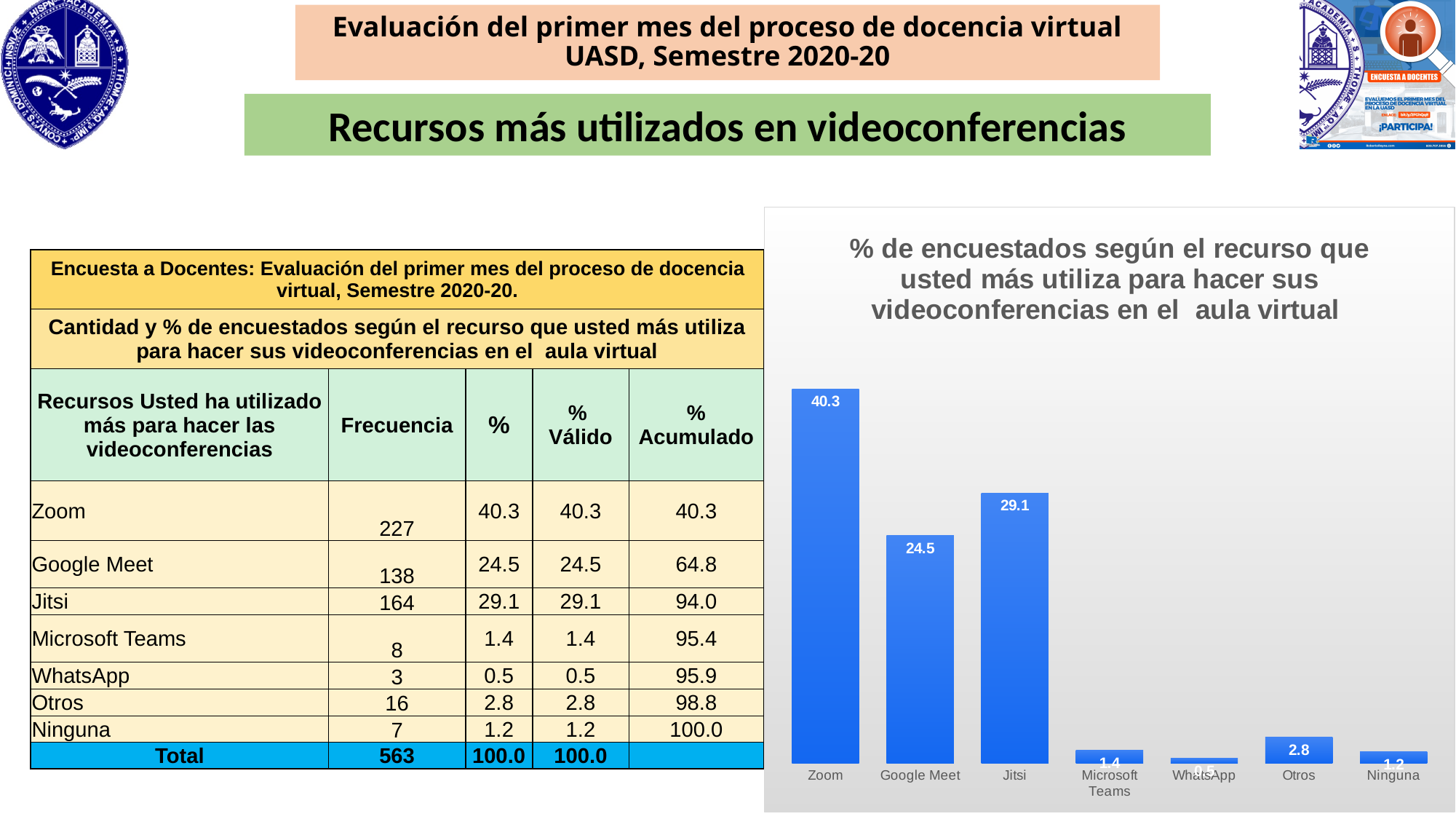
What is the value for Google Meet in the bar chart? 24.5 How many categories are shown in the bar chart? 7 What is the difference between the values for Zoom and Jitsi in the bar chart? 11.2 What is the difference between the values for Jitsi and Google Meet in the bar chart? 4.6 What is the value for Zoom in the bar chart? 40.3 What is the value for Jitsi in the bar chart? 29.1 Which category has the highest value in the bar chart? Zoom Which has a larger value in the bar chart, Google Meet or Jitsi? Jitsi What type of chart is shown on the slide? bar chart What is the title of the bar chart? % de encuestados según el recurso que usted más utiliza para hacer sus videoconferencias en el aula virtual What is the value for Otros in the bar chart? 2.8 Which category has the lowest value in the bar chart? WhatsApp